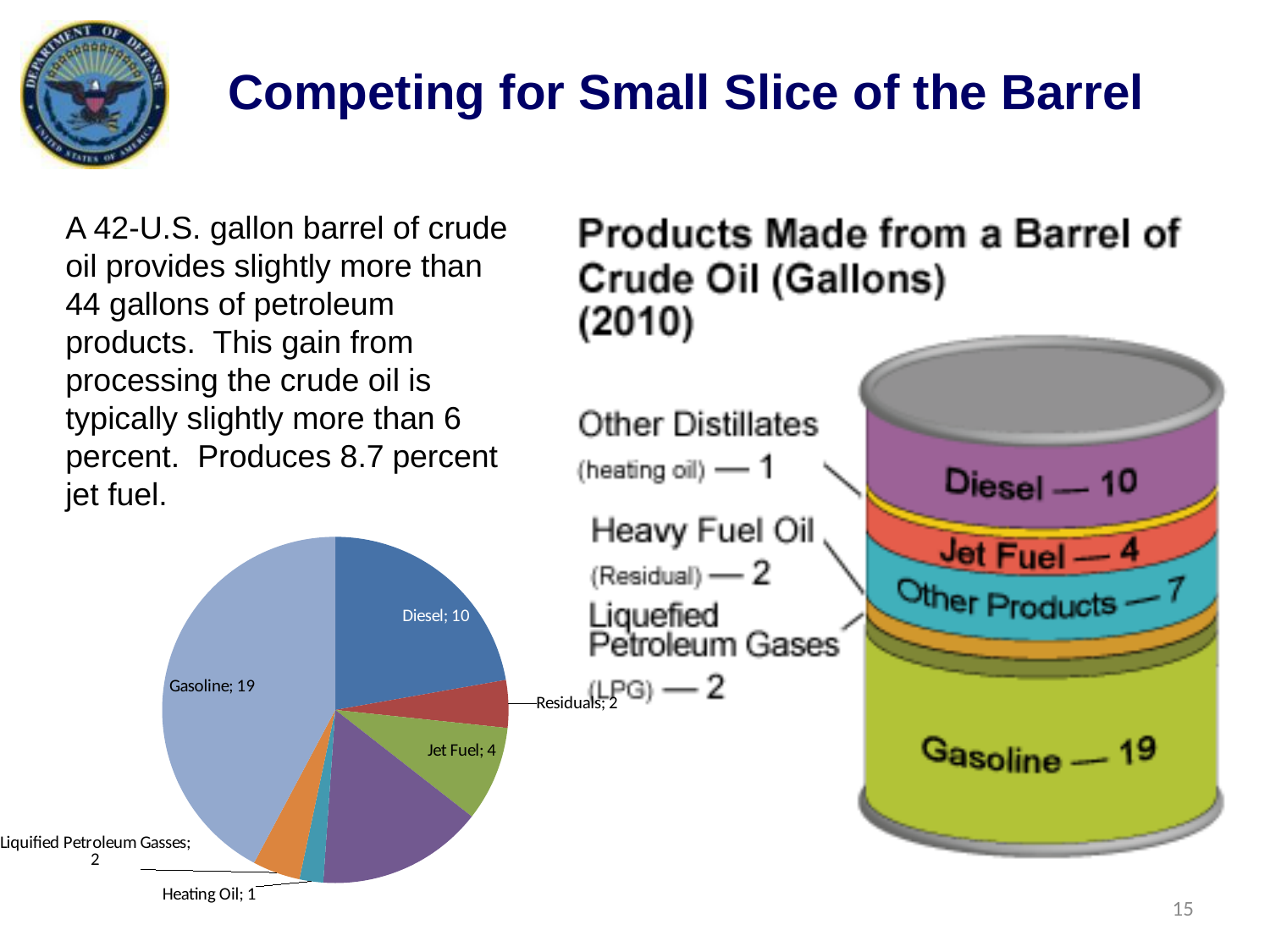
What kind of chart is shown at the bottom left of the slide? pie chart In the pie chart, what is the value for Diesel? 10 In the pie chart, which category has the largest slice? Gasoline In the pie chart, which is larger, Diesel or Jet Fuel? Diesel How many slices does the pie chart have? 7 In the pie chart, what is the value for Heating Oil? 1 In the pie chart, what is the value for Liquified Petroleum Gasses? 2 In the pie chart, which labelled category has the smallest slice? Heating Oil In the pie chart, what is the value for Jet Fuel? 4 In the pie chart, what is the difference between the values for Diesel and Jet Fuel? 6 In the pie chart, what is the value for Gasoline? 19 In the pie chart, what is the difference between the values for Gasoline and Diesel? 9